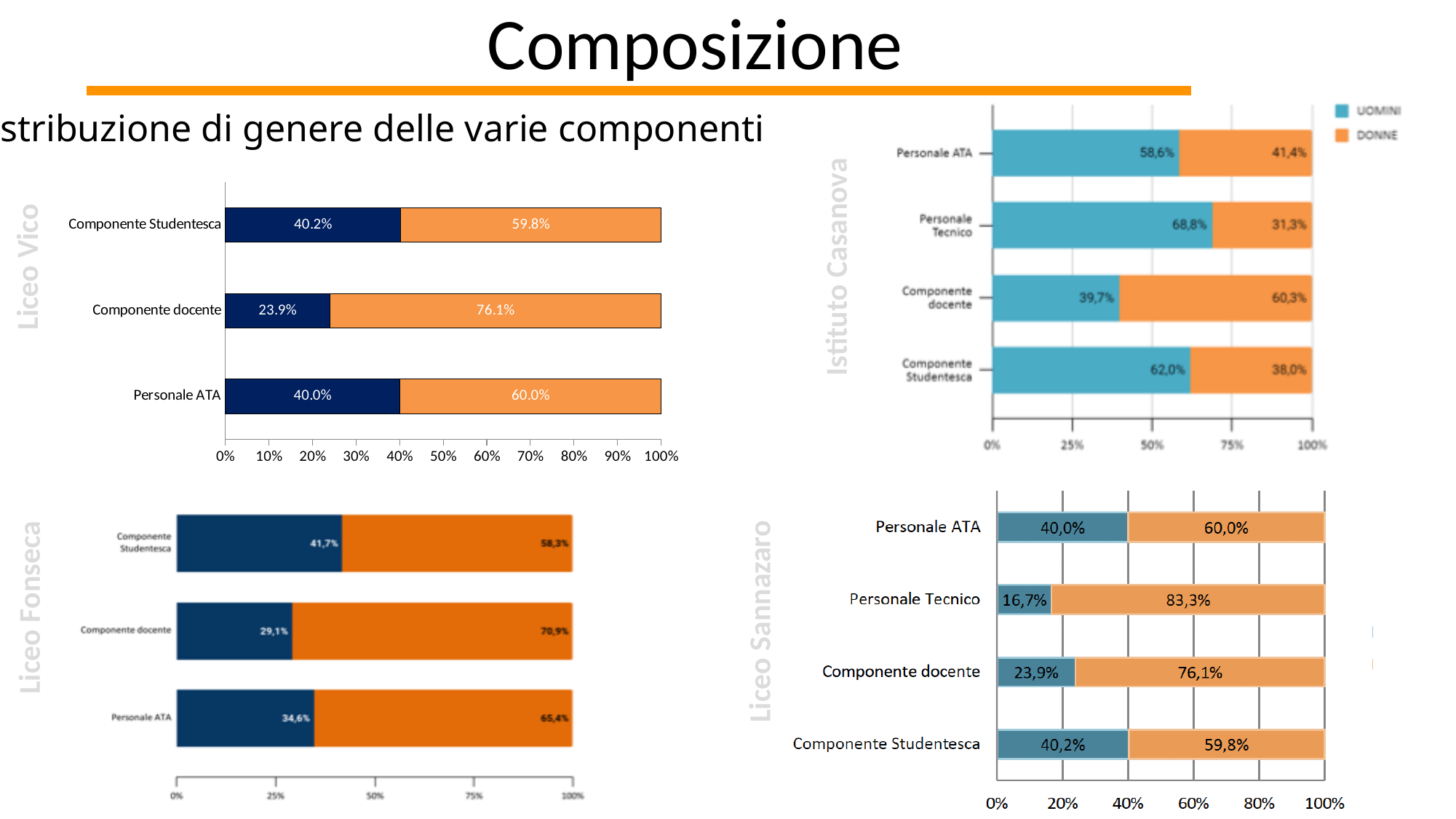
What kind of chart is the Liceo Vico chart? Stacked bar chart How many series does the legend of the Istituto Casanova chart list? 2 In the Istituto Casanova chart, what is the UOMINI value for Personale Tecnico? 68,8% How many categories are shown in the Liceo Sannazaro chart? 4 In the Liceo Fonseca chart, which category has the smallest dark blue segment? Componente docente In the Liceo Fonseca chart, what is the value of the orange segment for Personale ATA? 65,4% In the Istituto Casanova chart, which category has the highest DONNE share? Componente docente In the Liceo Sannazaro chart, what is the value of the orange segment for Personale Tecnico? 83,3% In the Liceo Vico chart, what is the value of the dark blue segment for Componente docente? 23.9% How many categories are shown in the Liceo Vico chart? 3 In the Liceo Sannazaro chart, what is the difference between the orange and blue segments for Componente docente? 52,2 percentage points In the Istituto Casanova chart, which is larger: the UOMINI value for Personale ATA or for Componente Studentesca? Componente Studentesca